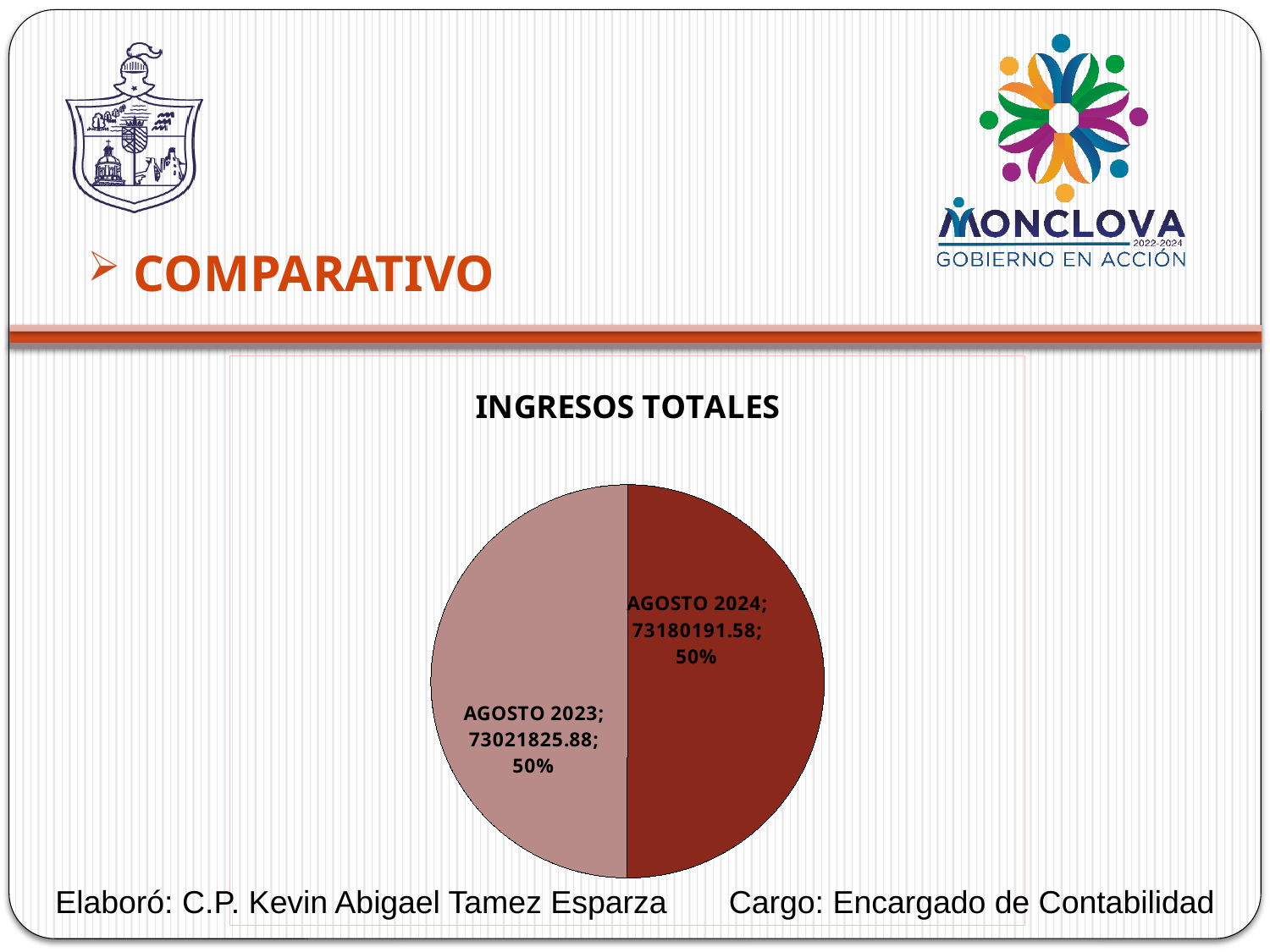
What percentage share does the AGOSTO 2024 slice have? 50% What is the total of the two values shown in the pie chart? 146202017.46 Which slice is drawn in the darker red colour? AGOSTO 2024 What percentage share does the AGOSTO 2023 slice have? 50% How many slices does the pie chart have? 2 According to the data labels, which category has the lowest value? AGOSTO 2023 According to the data labels, which slice has the larger value, AGOSTO 2023 or AGOSTO 2024? AGOSTO 2024 What is the title of the chart? INGRESOS TOTALES What type of chart is shown on the slide? Pie chart What is the difference between the AGOSTO 2024 value and the AGOSTO 2023 value? 158365.70 What is the value shown for AGOSTO 2023? 73021825.88 What is the value shown for AGOSTO 2024? 73180191.58